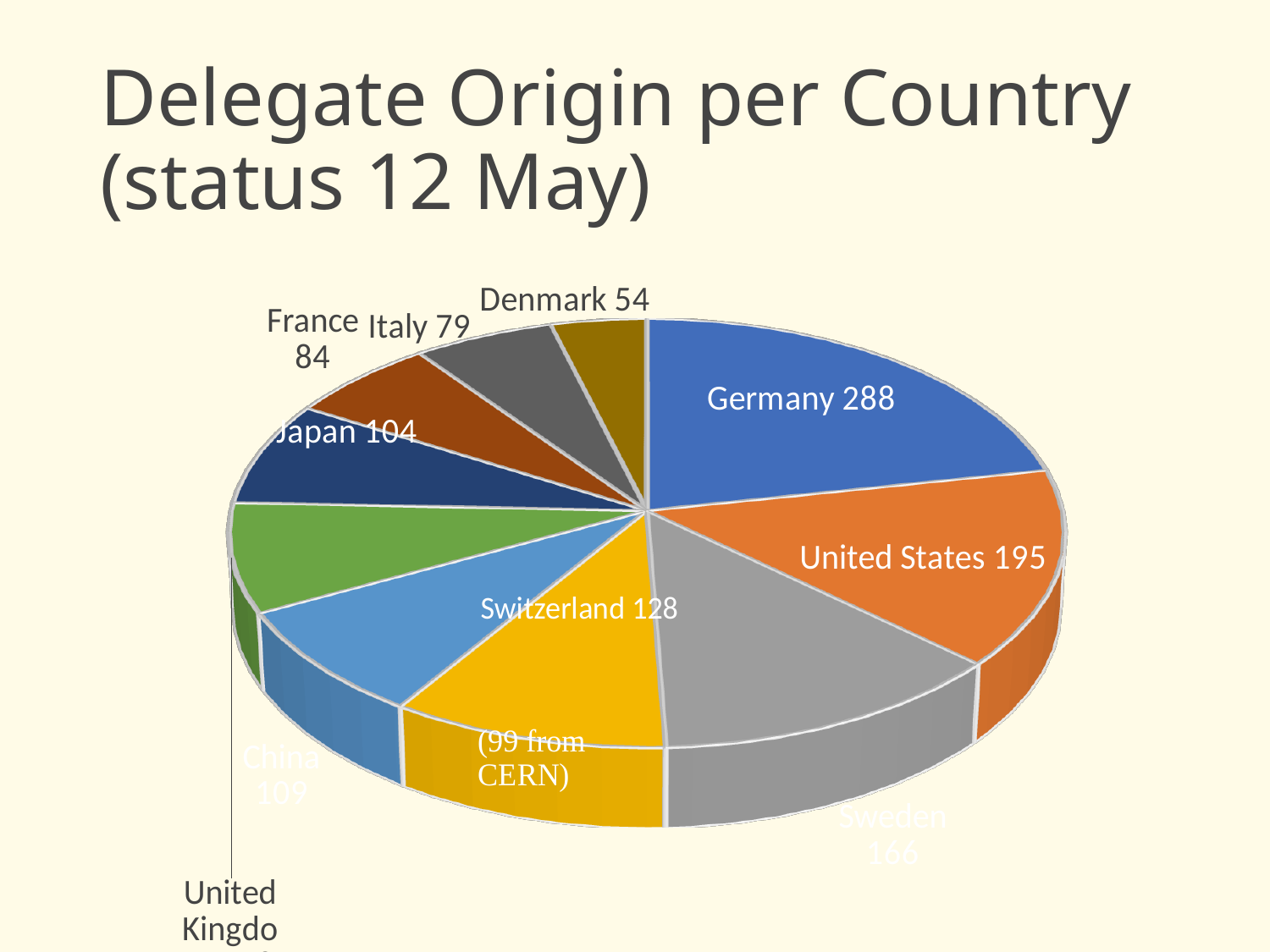
What is the value shown for France? 84 What is the value shown for the United States? 195 What is the difference between the values for Germany and the United States? 93 How many slices does the pie chart have? 10 What kind of chart is shown on the slide? Pie chart Which country has the largest slice of the pie? Germany What is the value shown for Denmark? 54 Which has a larger value, Japan or France? Japan Which country has the smallest slice of the pie? Denmark How many delegates are from Japan? 104 How many delegates are from Germany? 288 What is the value shown for Switzerland? 128